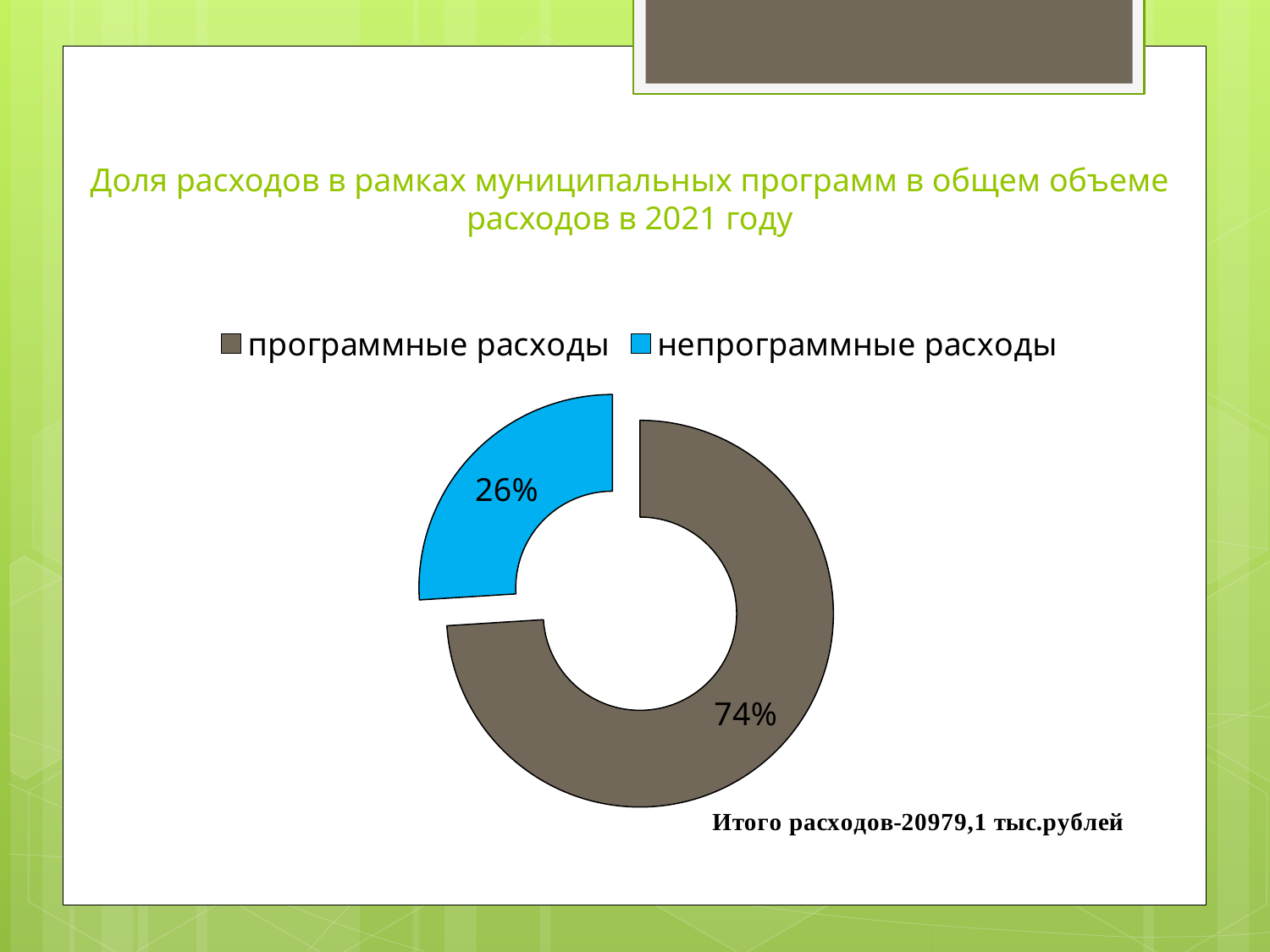
Which is larger: программные расходы or непрограммные расходы? программные расходы What colour is the segment for непрограммные расходы? blue What is the difference in percentage points between программные расходы and непрограммные расходы? 48 What share of the chart does непрограммные расходы represent? 26% What share of the chart does программные расходы represent? 74% Which category has the largest share in the chart? программные расходы Which category has the smallest share in the chart? непрограммные расходы What total expenditure amount is stated below the chart? 20979,1 тыс.рублей What kind of chart is shown on the slide? doughnut chart How many categories are shown in the chart? 2